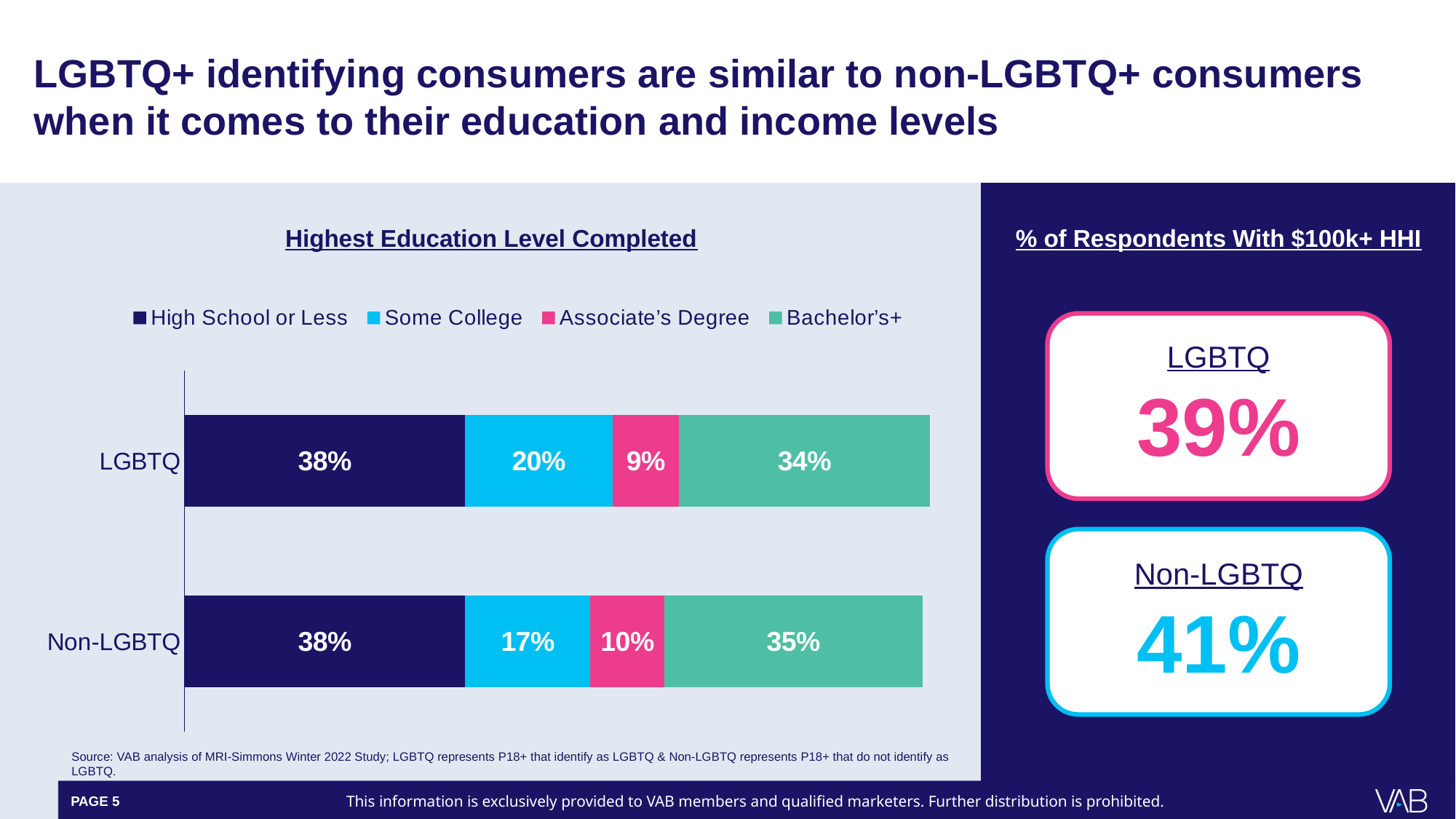
In the 'Highest Education Level Completed' chart, what percentage of Non-LGBTQ respondents have a Bachelor's+? 35% In the 'Highest Education Level Completed' chart, what is the difference between the Some College percentages for LGBTQ and Non-LGBTQ respondents? 3% In the 'Highest Education Level Completed' chart, which education level is the smallest segment for Non-LGBTQ respondents? Associate's Degree In the 'Highest Education Level Completed' chart, what is the total of the LGBTQ bar's segments? 101% In the 'Highest Education Level Completed' chart, which group has a higher Bachelor's+ percentage, LGBTQ or Non-LGBTQ? Non-LGBTQ In the 'Highest Education Level Completed' chart, what percentage of Non-LGBTQ respondents have High School or Less? 38% In the 'Highest Education Level Completed' chart, what percentage of LGBTQ respondents have Some College? 20% In the '% of Respondents With $100k+ HHI' panel, what is the value for LGBTQ? 39% In the 'Highest Education Level Completed' chart, which education level is the largest segment for LGBTQ respondents? High School or Less What kind of chart is the 'Highest Education Level Completed' chart? Stacked bar chart How many series does the legend of the 'Highest Education Level Completed' chart list? 4 In the 'Highest Education Level Completed' chart, what percentage of LGBTQ respondents have an Associate's Degree? 9%